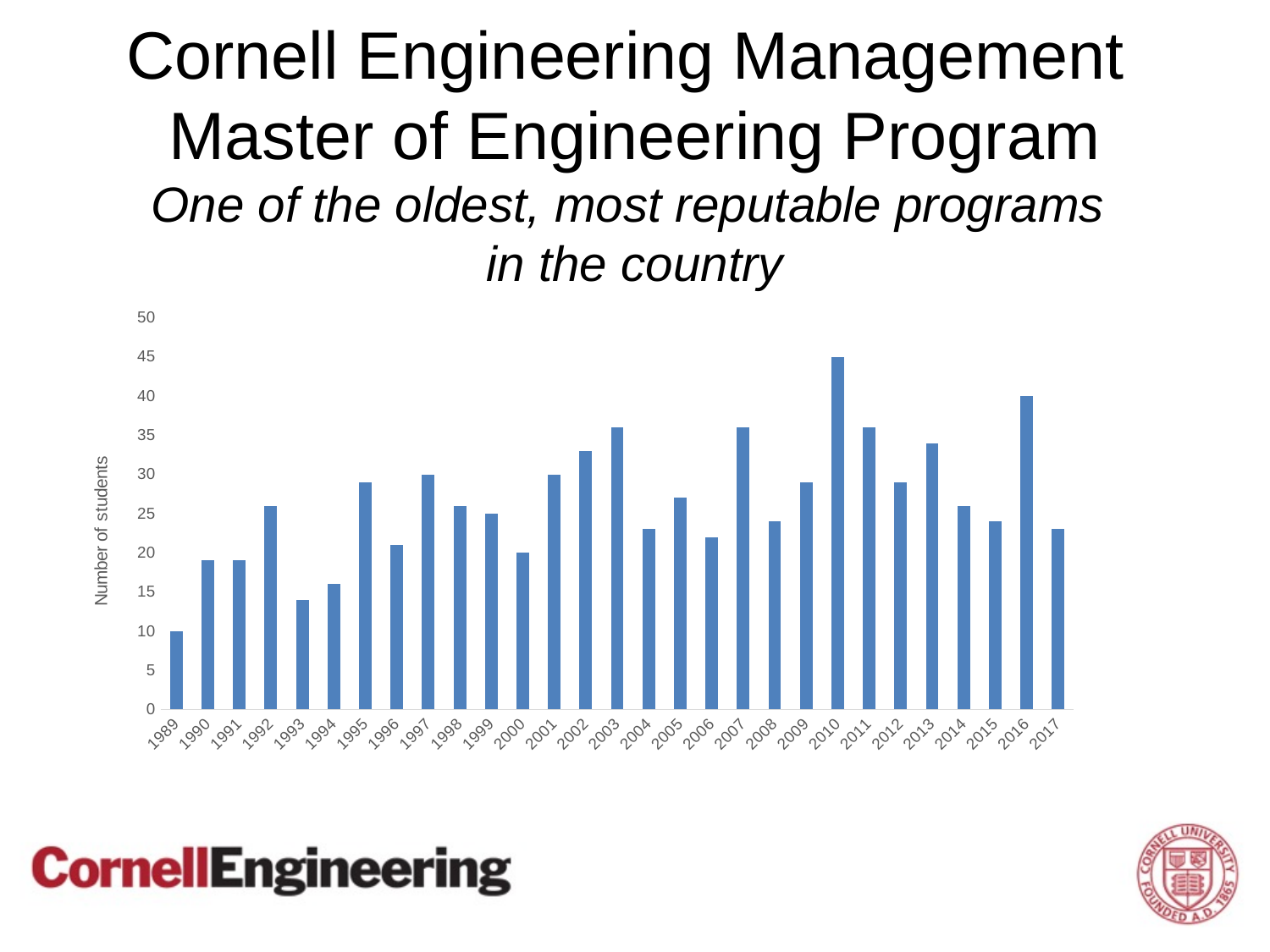
Which year has the highest number of students? 2010 What is the number of students for 1989? 10 Is the value for 2013 greater or less than 30? greater Which year has the lowest number of students? 1989 Is the value for 1994 greater or less than 20? less What type of chart is shown on the slide? bar chart Is the value for 2016 greater or less than 35? greater How many years are shown on the x axis of the chart? 29 What is the label on the y axis of the chart? Number of students Which year has more students, 2010 or 2016? 2010 What is the number of students for 2010? 45 Which year has more students, 1989 or 1993? 1993